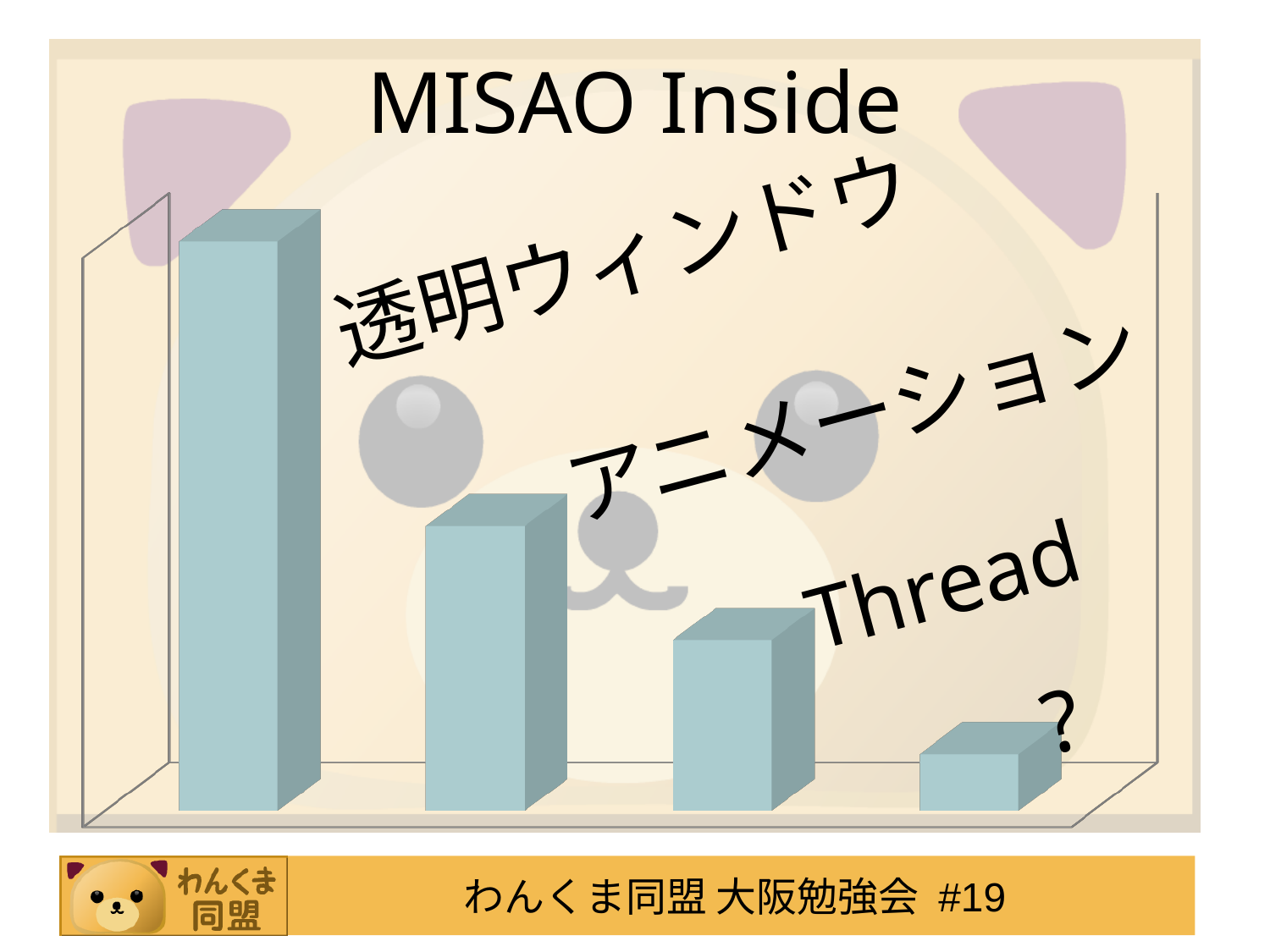
Does the chart display any numeric data labels or axis values? No Which bar is the tallest: the leftmost or the rightmost? the leftmost Which bar is the shortest: the leftmost or the rightmost? the rightmost How many bars does the chart show? 4 Do the bar heights rise or fall from left to right across the chart? fall Is the second bar from the left taller or shorter than the third bar from the left? taller What is the title shown above the chart? MISAO Inside What kind of chart is shown on the slide? bar chart